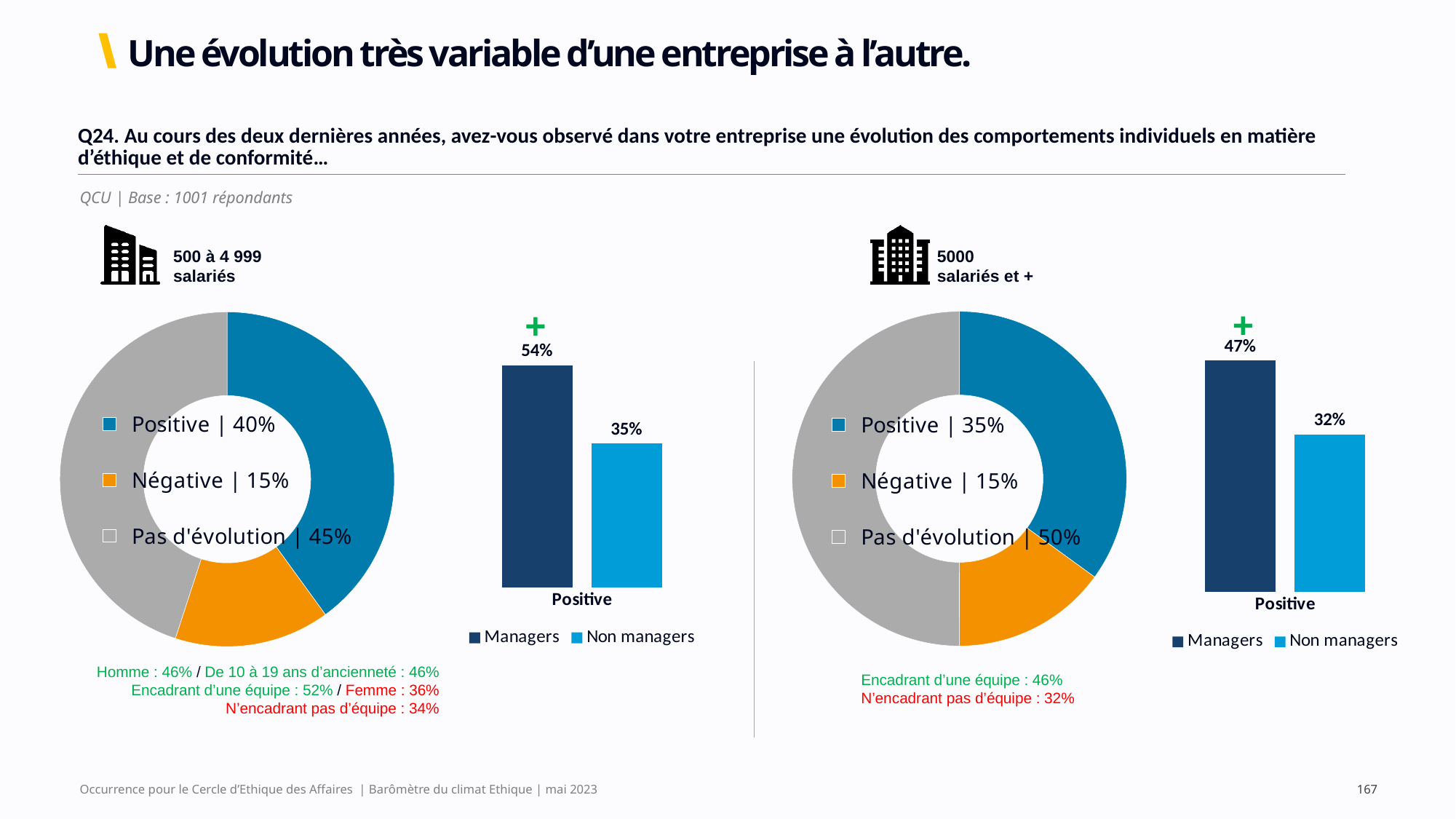
In the bar chart for '5000 salariés et +', which is larger, Managers or Non managers? Managers In the donut chart for '5000 salariés et +', which category has the largest share? Pas d'évolution How many series does the legend of the bar chart for '500 à 4 999 salariés' list? 2 In the bar chart for '5000 salariés et +', what is the value for Non managers? 32% In the bar chart for '5000 salariés et +', what is the difference between Managers and Non managers? 15 percentage points In the bar chart for '500 à 4 999 salariés', what is the difference between Managers and Non managers? 19 percentage points In the bar chart for '500 à 4 999 salariés', what is the value for Managers? 54% In the donut chart for '500 à 4 999 salariés', what share is 'Positive'? 40% In the donut chart for '5000 salariés et +', what share is 'Pas d'évolution'? 50% In the donut chart for '500 à 4 999 salariés', what share is 'Négative'? 15% In the donut chart for '500 à 4 999 salariés', which category has the smallest share? Négative What kind of chart is used to show the Positive / Négative / Pas d'évolution breakdown for each company size? Donut (pie) chart